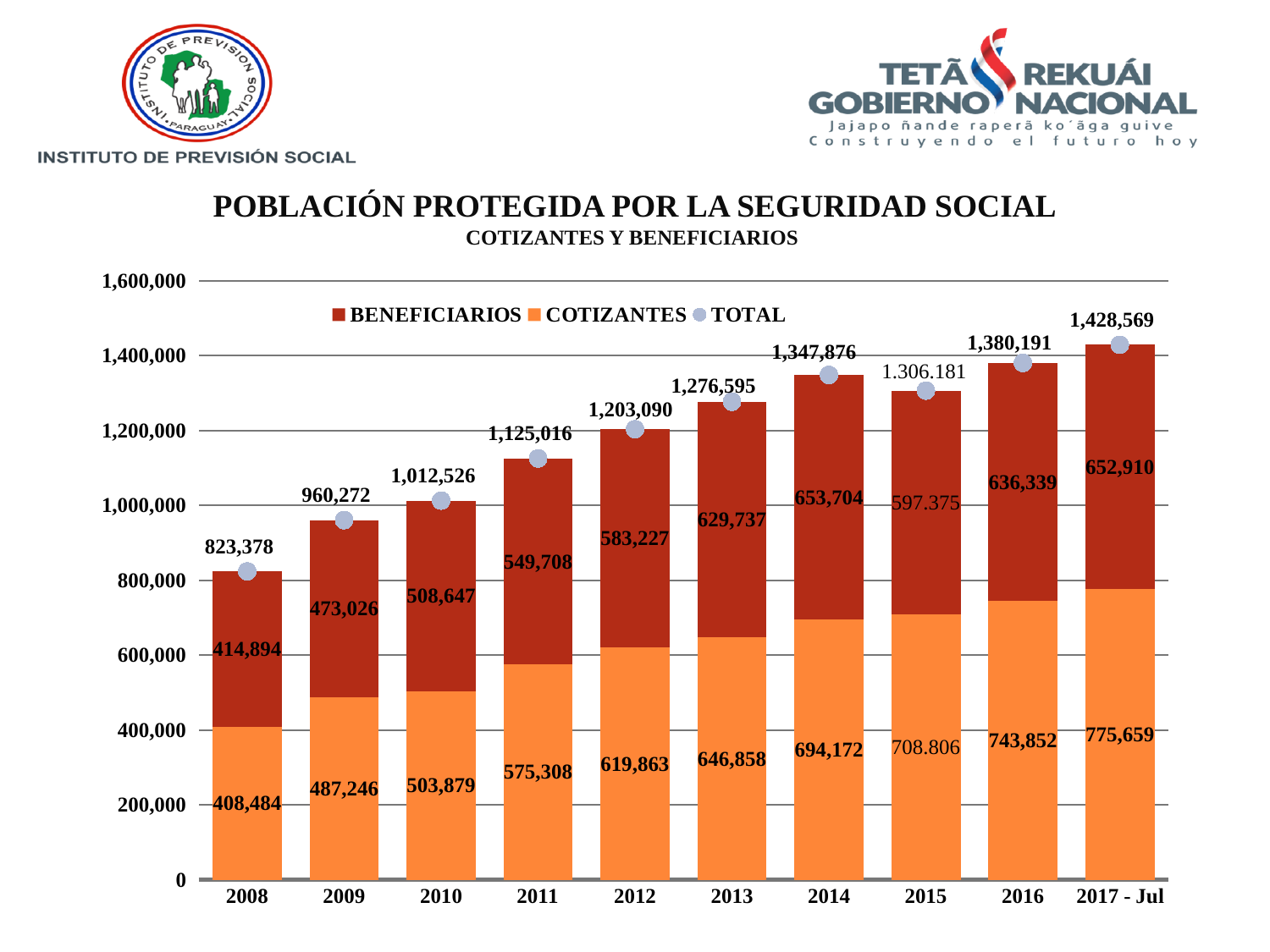
What is the difference between the COTIZANTES values for 2016 and 2008? 335,368 What is the BENEFICIARIOS value for 2015? 597.375 Which is larger in 2011, COTIZANTES or BENEFICIARIOS? COTIZANTES Do the TOTAL values generally rise or fall from 2008 to 2017 - Jul? Rise What is the COTIZANTES value for 2012? 619,863 How many series does the legend list? 3 What is the TOTAL value for 2017 - Jul? 1,428,569 How many years are shown on the x axis? 10 What is the BENEFICIARIOS value for 2014? 653,704 Which year has the lowest COTIZANTES value? 2008 Which year has the highest TOTAL value? 2017 - Jul What kind of chart is shown on the slide? Stacked bar chart